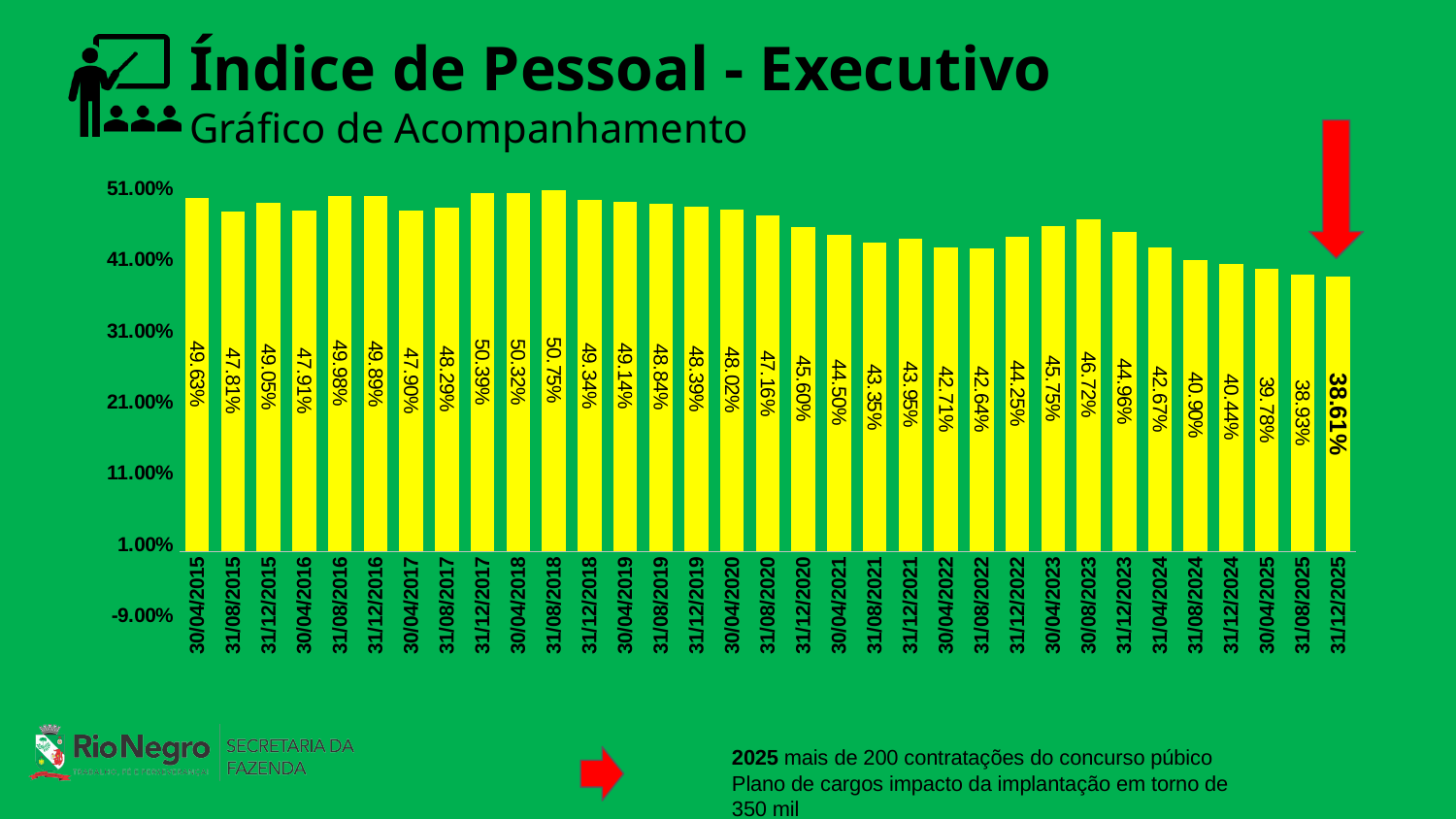
Do the values generally rise or fall from 2018 to 2025? fall What is the value for 31/08/2018? 50.75% What is the value for 31/08/2022? 42.64% Which date has the highest value? 31/08/2018 What is the title of the chart on the slide? Índice de Pessoal - Executivo Which date has the lowest value? 31/12/2025 What is the difference between the values for 30/04/2015 and 31/12/2025? 11.02 percentage points What type of chart is shown on the slide? bar chart What is the value for 31/12/2025? 38.61% How many bars are plotted in the chart? 33 What is the value for 30/04/2015? 49.63%